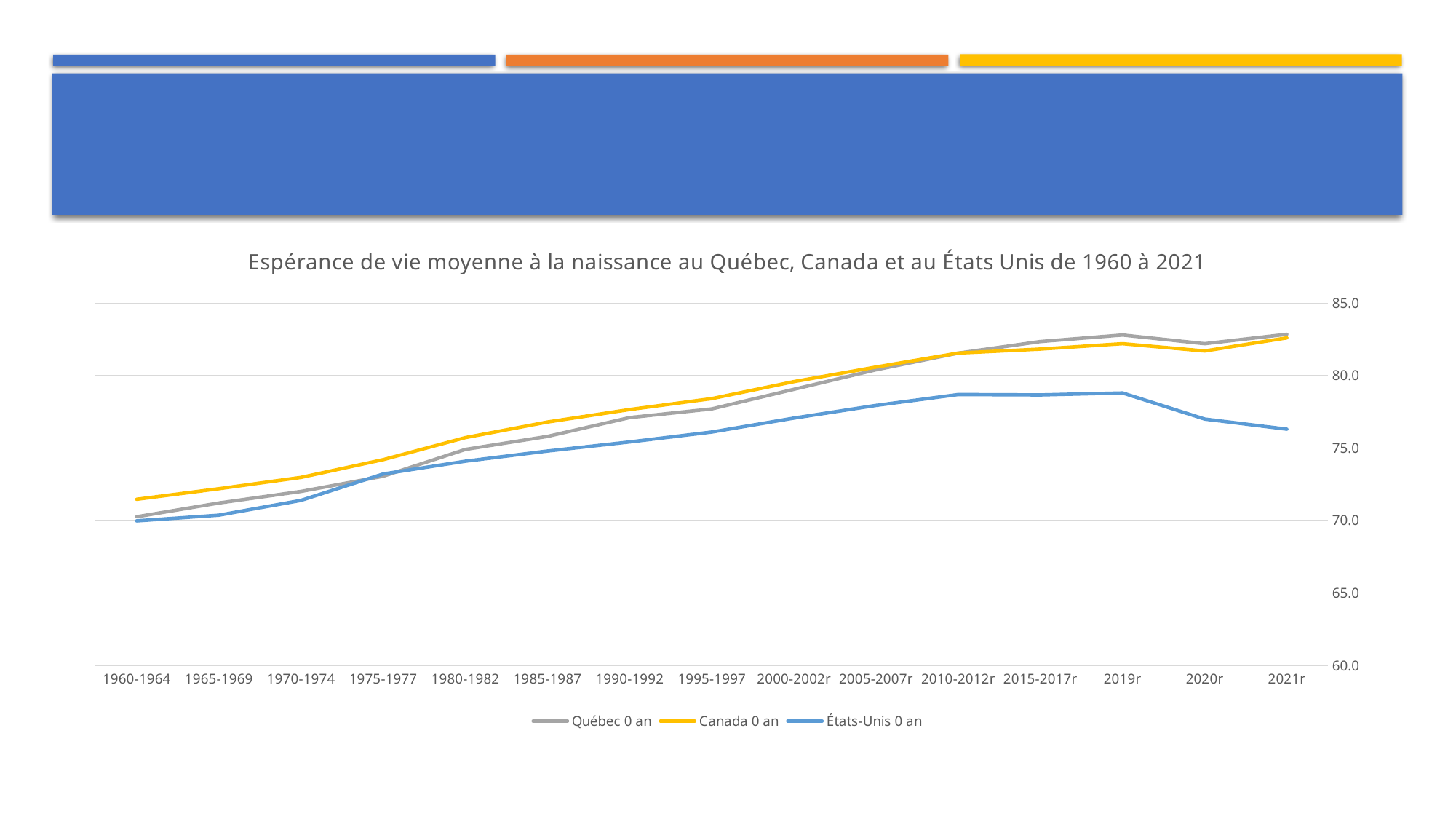
How many series does the legend list? 3 Does the États-Unis 0 an series rise or fall from 2019r to 2021r? fall Which series is drawn in blue? États-Unis 0 an Is the value for États-Unis 0 an in 2019r greater or less than 80.0? less What is the title of the chart? Espérance de vie moyenne à la naissance au Québec, Canada et au États Unis de 1960 à 2021 Which series has the lowest value in 2021r? États-Unis 0 an Is the value for Québec 0 an in 2019r greater or less than 80.0? greater Is the value for Canada 0 an in 1990-1992 greater or less than 75.0? greater How many periods are shown along the x axis? 15 In 2021r, which is larger: Québec 0 an or États-Unis 0 an? Québec 0 an What kind of chart is shown on the slide? line chart